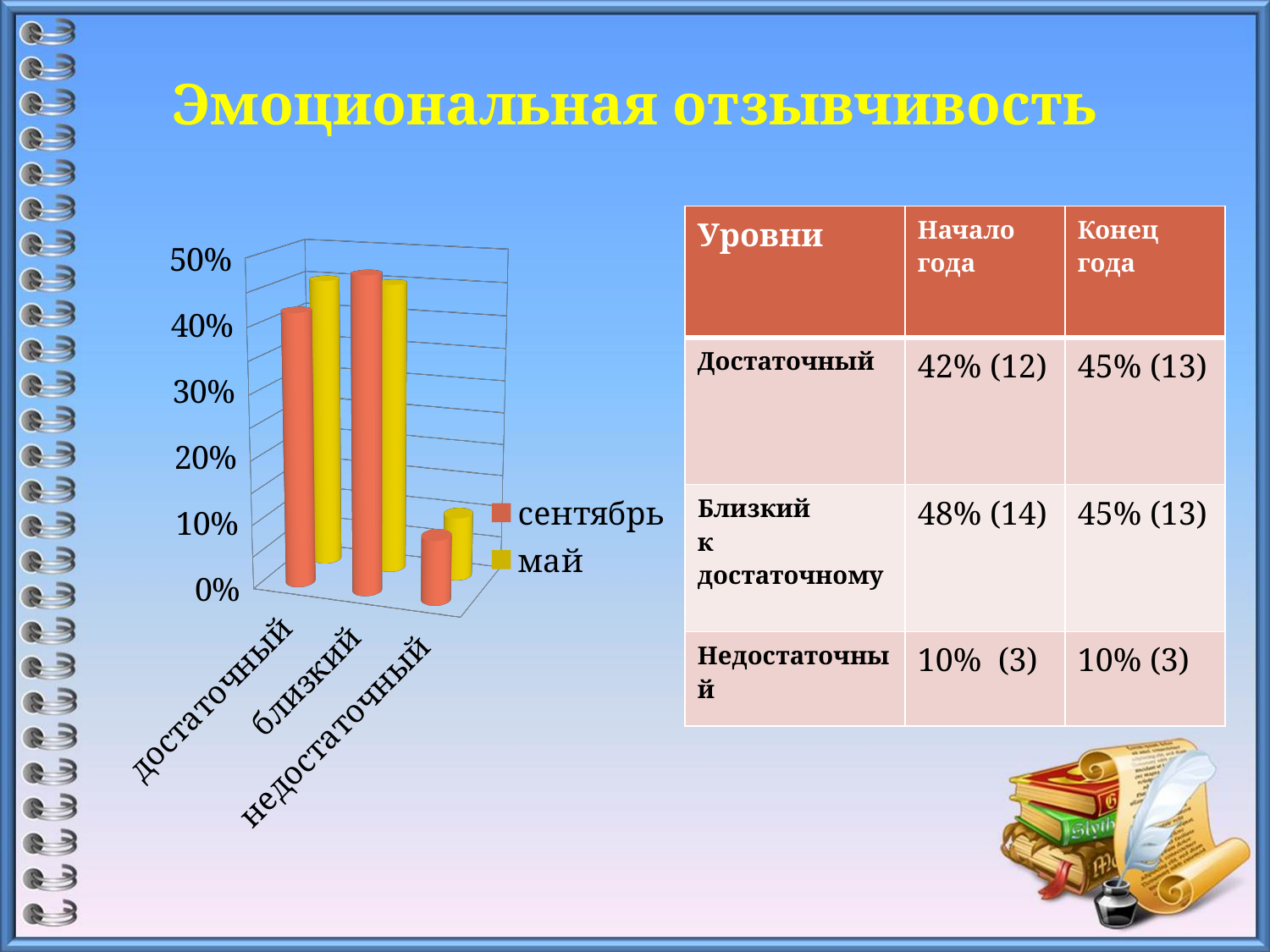
Which category has the lowest value for the series май? недостаточный Is the value for близкий in the series сентябрь greater or less than 40%? greater How many series does the chart legend list? 2 Is the value for недостаточный in the series сентябрь greater or less than 20%? less Which category has the lowest value for the series сентябрь? недостаточный What colour are the bars for the series май? yellow For the series сентябрь, which is larger: достаточный or недостаточный? достаточный What kind of chart is shown on the slide? bar chart Which two series are listed in the chart legend? сентябрь and май Is the value for достаточный in the series май greater or less than 30%? greater How many categories are shown on the x axis of the chart? 3 Which category has the highest value for the series сентябрь? близкий